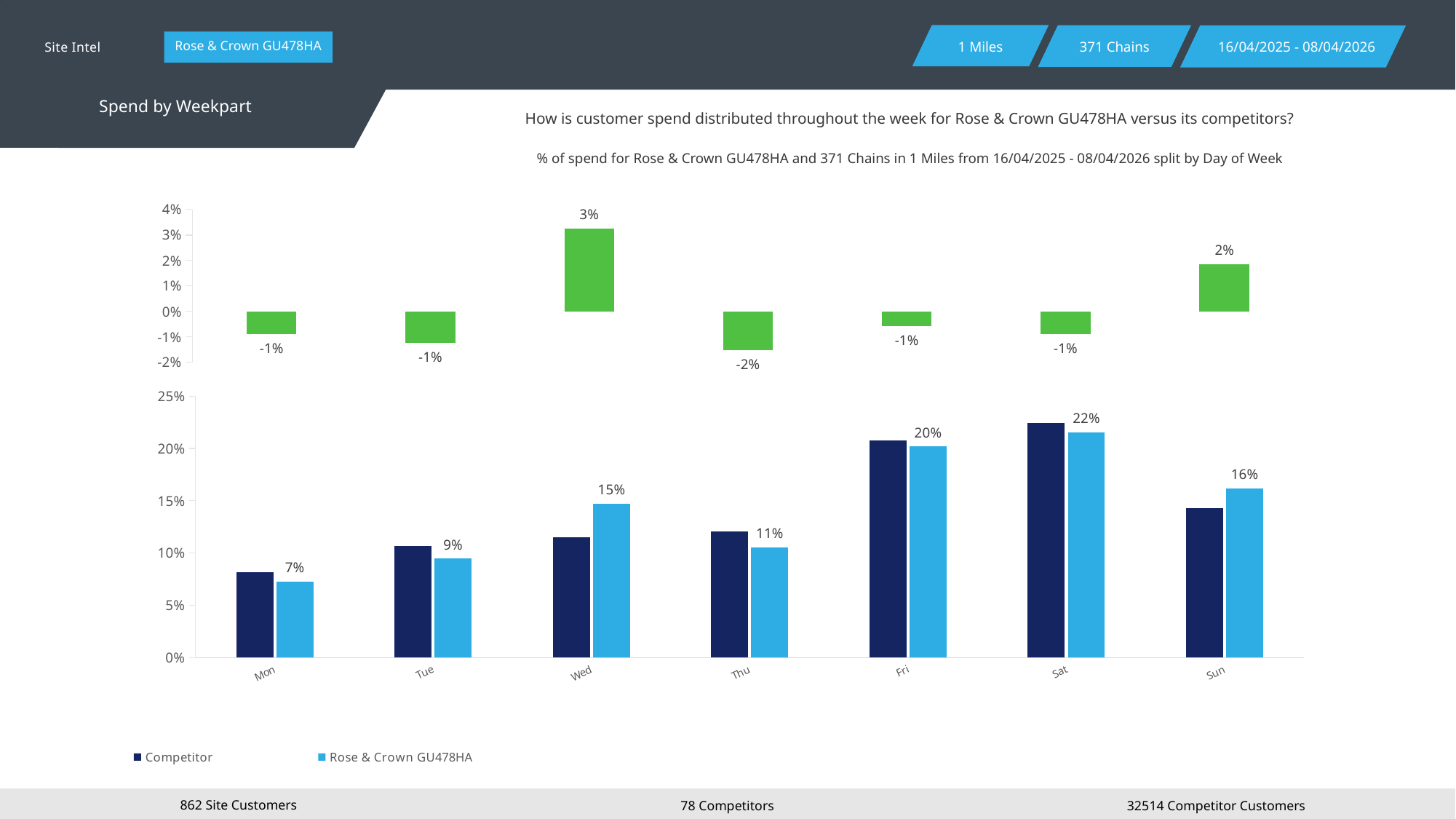
In the bottom chart, is the Competitor value for Mon greater or less than 10%? less In the bottom chart, what is the difference between the Rose & Crown GU478HA values for Sat and Mon? 15% In the bottom chart, is the Competitor value for Fri greater or less than 15%? greater In the bottom chart, which series has the larger value on Wed, Competitor or Rose & Crown GU478HA? Rose & Crown GU478HA In the top chart, which day has the lowest value? Thu In the bottom chart, what is the value for Rose & Crown GU478HA on Sat? 22% In the bottom chart, on which day is the Rose & Crown GU478HA value highest? Sat In the bottom chart, on which day is the Rose & Crown GU478HA value lowest? Mon How many days of the week are shown on the x axis of the bottom chart? 7 What type of chart is the bottom chart? Bar chart How many series does the legend of the bottom chart list? 2 In the top chart, what is the value shown for Wed? 3%